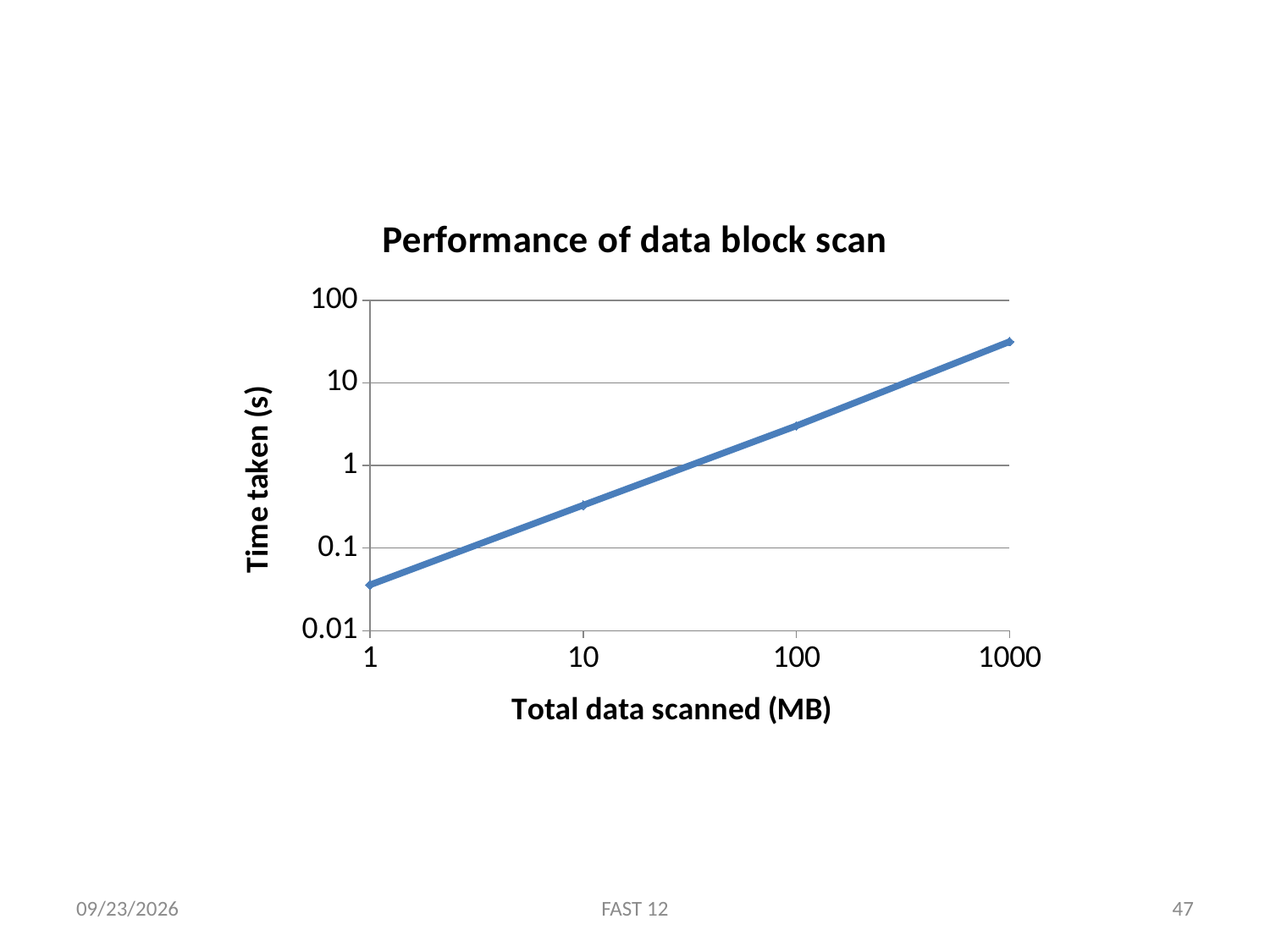
At which total data scanned value is the time taken lowest? 1 Is the time taken for 1000 MB of data scanned greater or less than 10 s? greater What kind of chart is shown on the slide? line chart Is the time taken for 10 MB of data scanned greater or less than 1 s? less What is the label of the y axis? Time taken (s) Which takes more time: scanning 100 MB or scanning 10 MB? 100 MB How many data points are plotted on the line? 4 Is the time taken for 100 MB of data scanned greater or less than 1 s? greater What is the title of the chart? Performance of data block scan At which total data scanned value is the time taken highest? 1000 Does the time taken rise or fall as the total data scanned increases? rises